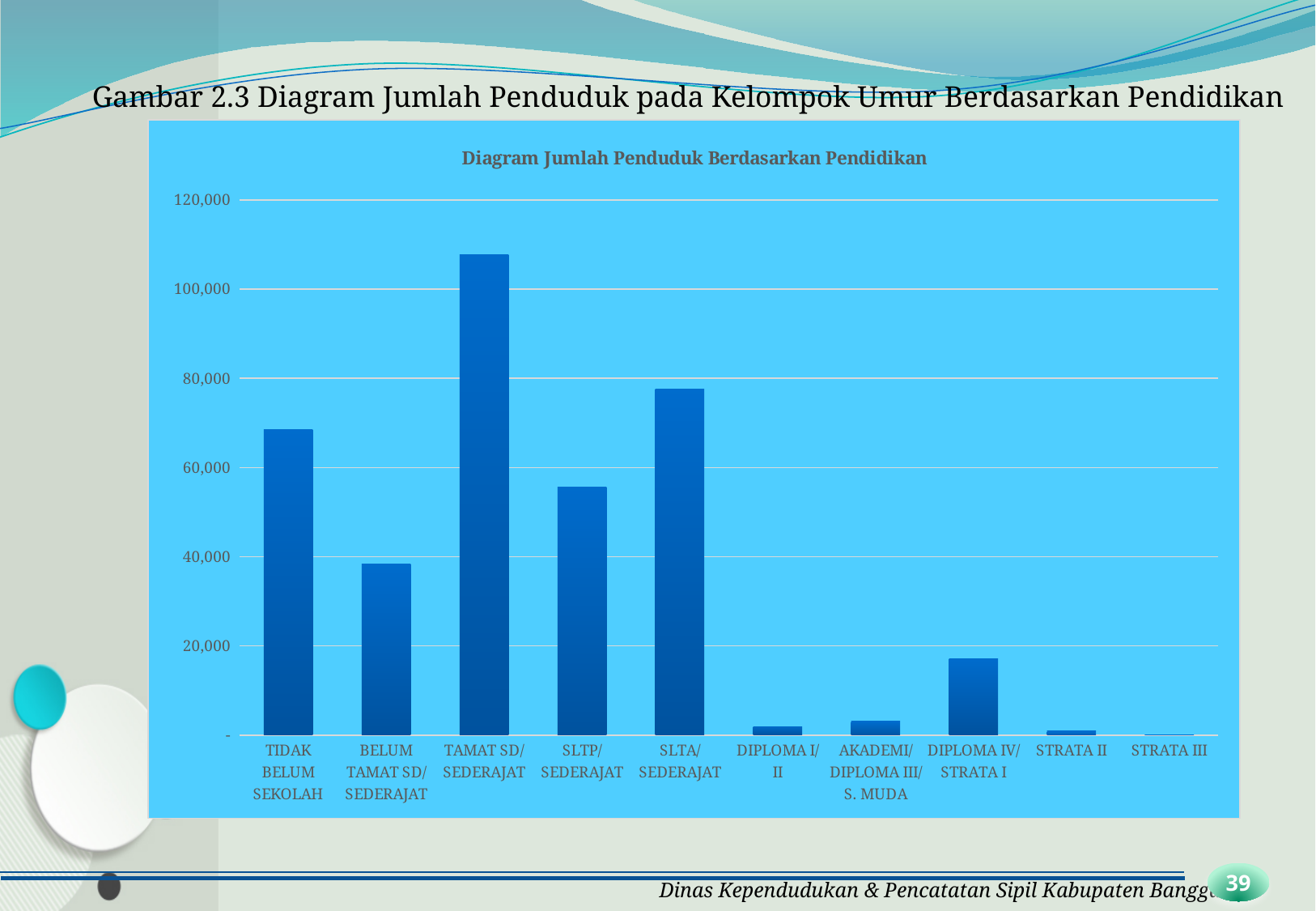
Which category has the lowest number of people? STRATA III Is the value for SLTA/ SEDERAJAT greater or less than 80,000? less What kind of chart is shown on the slide? Bar chart Is the value for DIPLOMA IV/ STRATA I greater or less than 20,000? less Which category has the highest number of people? TAMAT SD/ SEDERAJAT Which is larger, the value for SLTP/ SEDERAJAT or the value for BELUM TAMAT SD/ SEDERAJAT? SLTP/ SEDERAJAT Which is larger, the value for SLTA/ SEDERAJAT or the value for TIDAK BELUM SEKOLAH? SLTA/ SEDERAJAT What is the title printed inside the chart area? Diagram Jumlah Penduduk Berdasarkan Pendidikan Is the value for TAMAT SD/ SEDERAJAT greater or less than 100,000? greater How many education categories are plotted on the x axis? 10